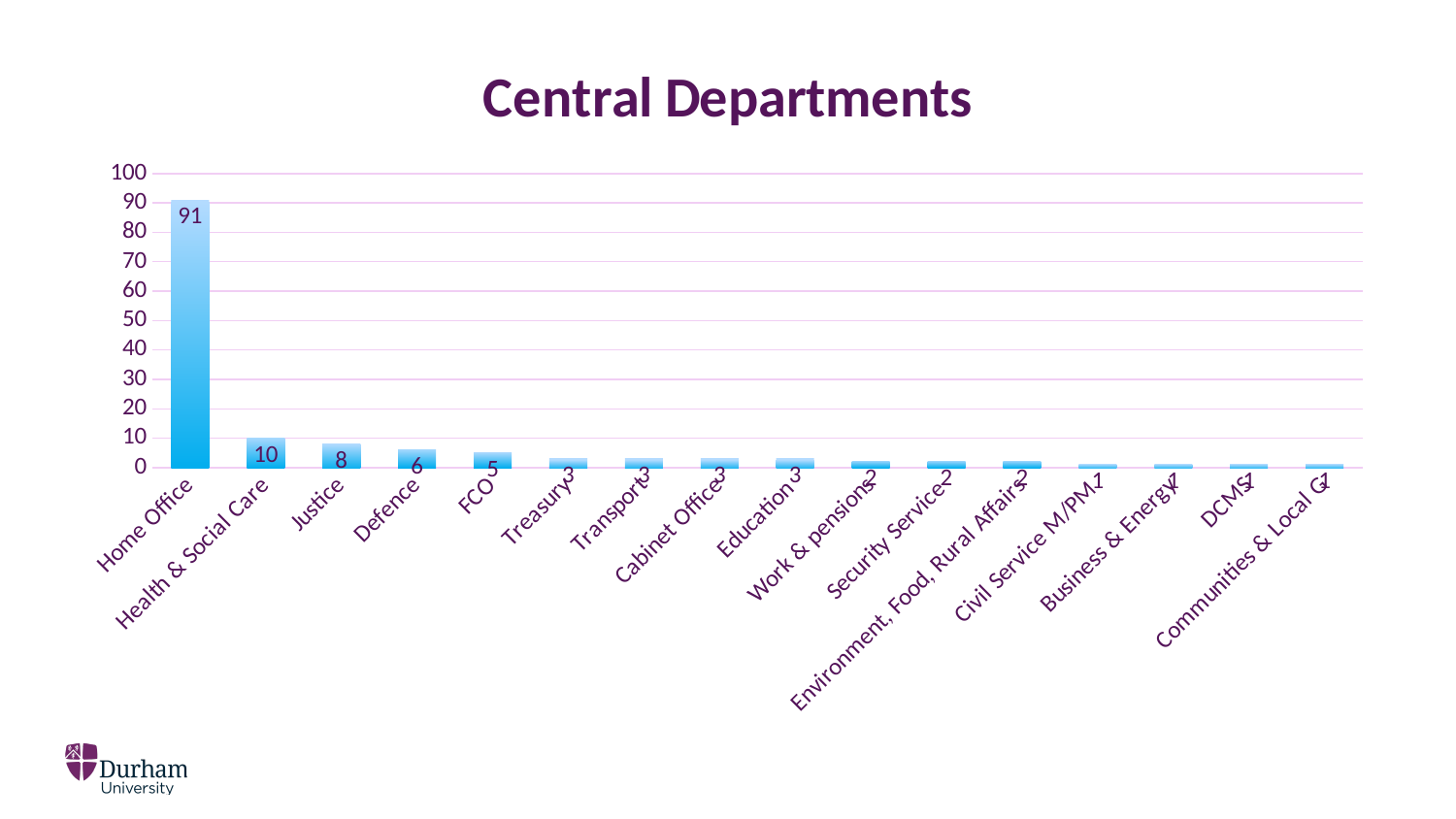
Is the value for Home Office greater or less than 50? greater What is the value for Justice? 8 What is the value for FCO? 5 How many departments are shown on the chart? 16 What is the value for Defence? 6 What is the difference between the values for Home Office and Health & Social Care? 81 What is the value for Health & Social Care? 10 What is the title of the chart? Central Departments What is the value for Home Office? 91 Which department has the highest value? Home Office Which has a larger value, Justice or Defence? Justice What kind of chart is shown on the slide? Bar chart